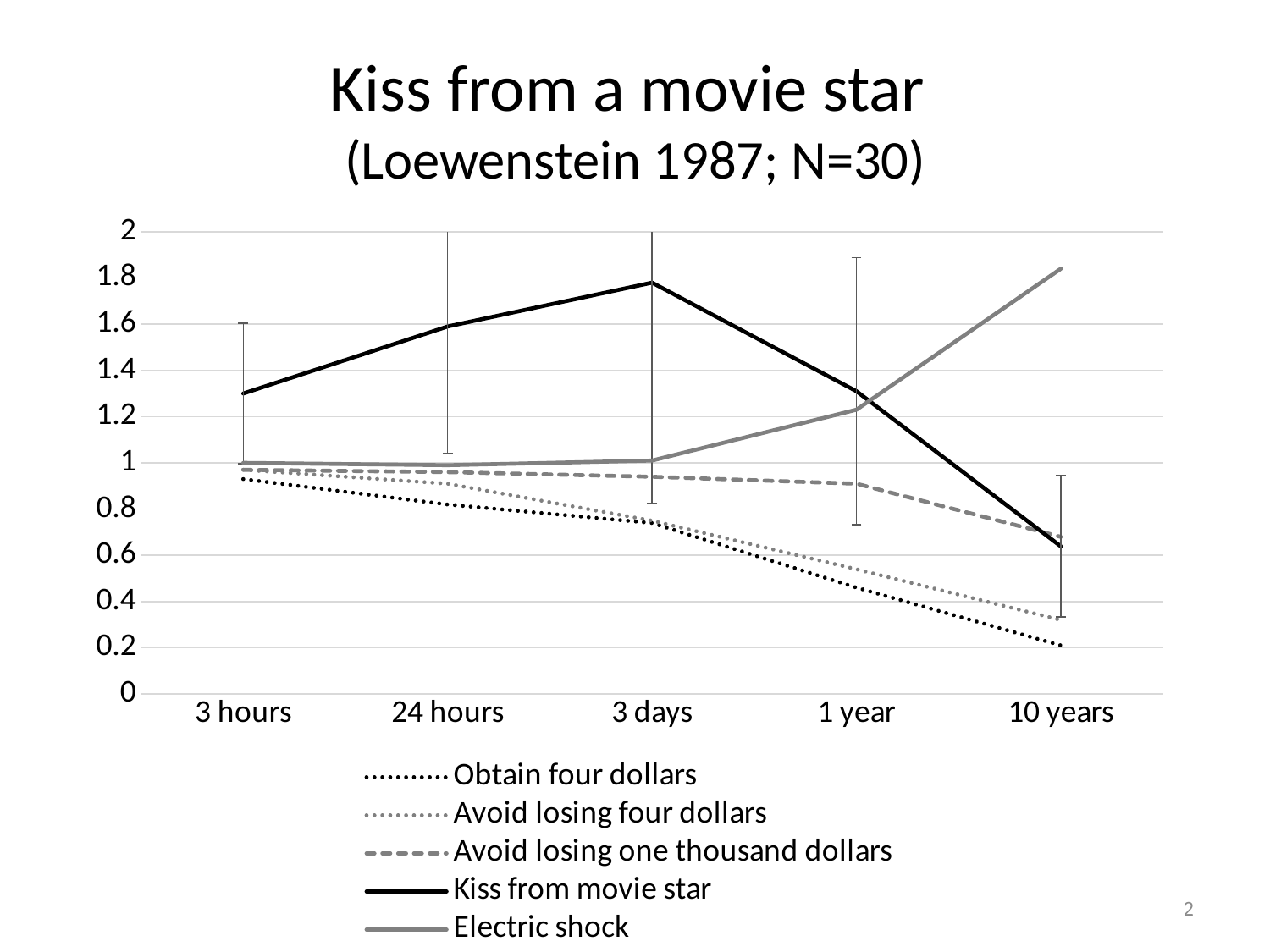
Does the Obtain four dollars series rise or fall from 3 hours to 10 years? fall Which series has the lowest value at 10 years? Obtain four dollars How many time categories are shown on the x axis? 5 Is the value for Obtain four dollars at 10 years greater or less than 0.4? less Is the value for Kiss from movie star at 3 days greater or less than 1.6? greater Which series has the highest value at 10 years? Electric shock What is the title of the chart? Kiss from a movie star (Loewenstein 1987; N=30) At which time category does the Kiss from movie star series reach its highest value? 3 days At 3 days, which is larger: Kiss from movie star or Electric shock? Kiss from movie star How many series does the legend list? 5 Is the value for Electric shock at 10 years greater or less than 1.6? greater What kind of chart is shown on the slide? line chart